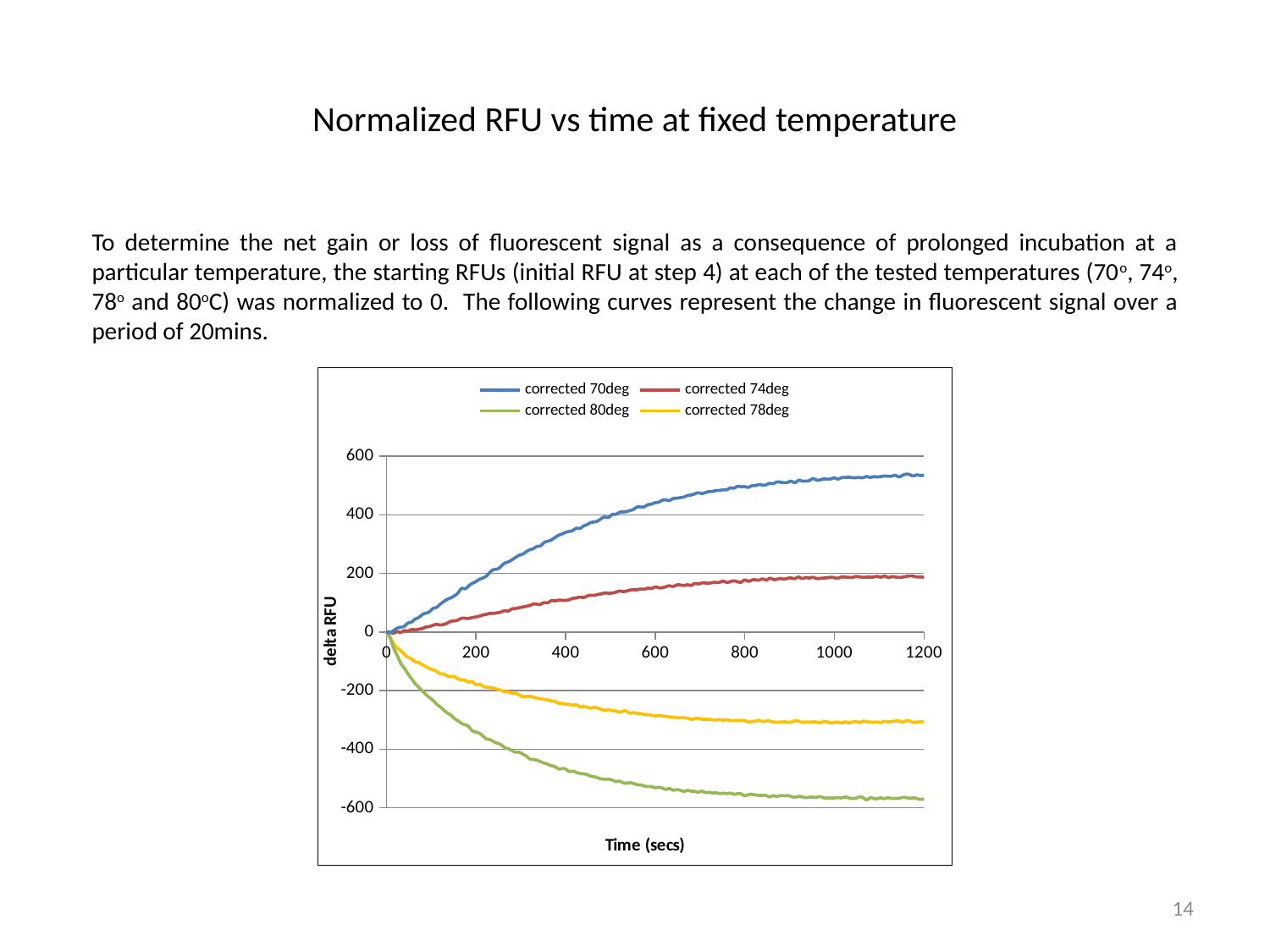
Is the value of the corrected 70deg series at 1200 secs greater or less than 400? greater Is the value of the corrected 78deg series at 1200 secs greater or less than -200? less What kind of chart is shown on the slide? line chart How many series does the chart's legend list? 4 Which series reaches the highest delta RFU value by the end of the time period? corrected 70deg What is the label of the chart's vertical axis? delta RFU What is the label of the chart's horizontal axis? Time (secs) Which series reaches the lowest delta RFU value by the end of the time period? corrected 80deg At 1200 secs, which series has the larger delta RFU value: corrected 74deg or corrected 78deg? corrected 74deg Does the corrected 80deg series rise or fall as time increases? fall Does the corrected 70deg series rise or fall as time increases? rise Is the value of the corrected 74deg series at 1200 secs greater or less than 200? less